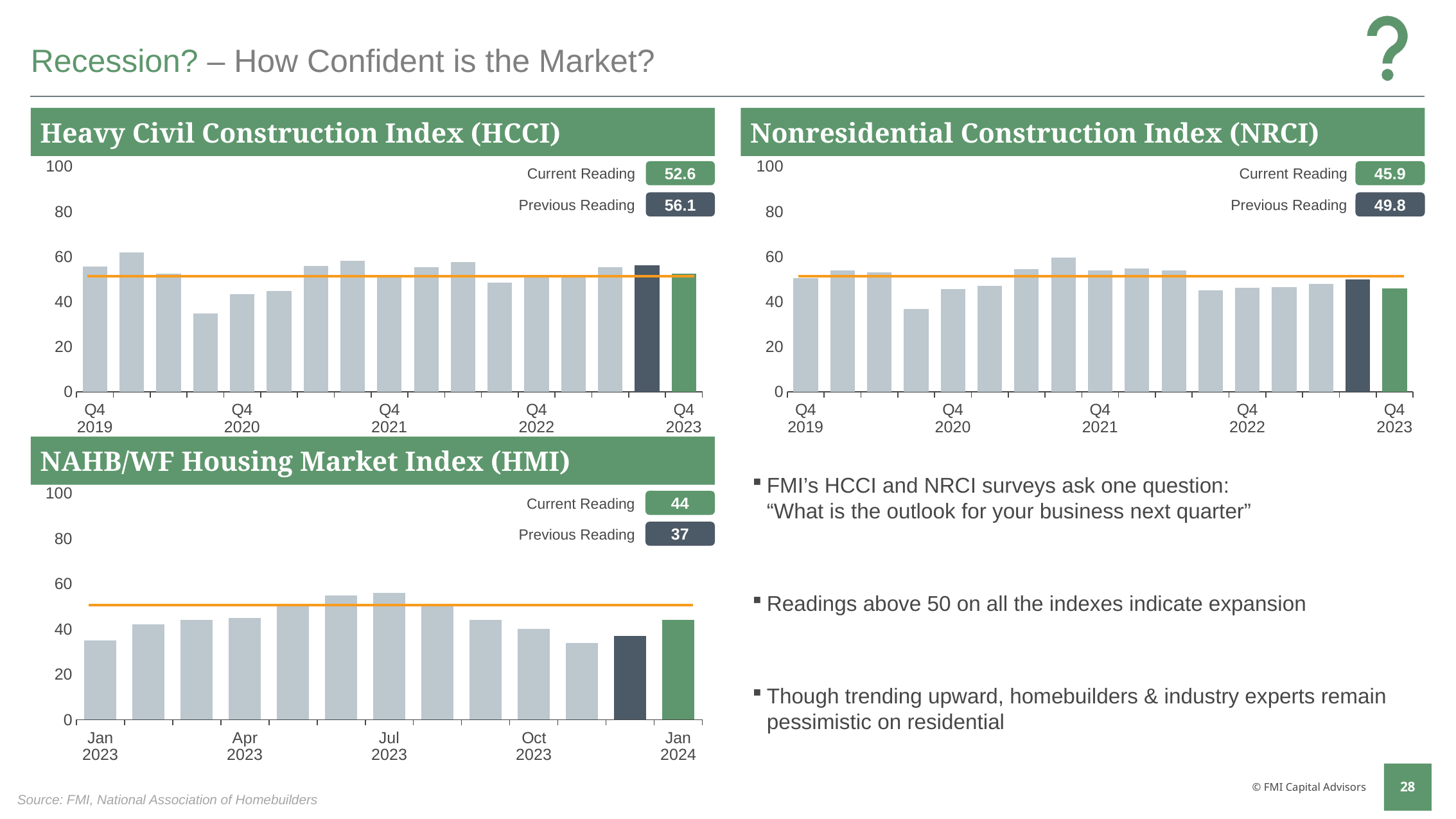
On the Nonresidential Construction Index (NRCI) chart, what is the Current Reading? 45.9 On the NAHB/WF Housing Market Index (HMI) chart, is the value for Jan 2023 greater or less than 40? less On the Heavy Civil Construction Index (HCCI) chart, what is the difference between the Previous Reading and the Current Reading? 3.5 On the Nonresidential Construction Index (NRCI) chart, which is larger, the Current Reading or the Previous Reading? Previous Reading On the NAHB/WF Housing Market Index (HMI) chart, what is the Current Reading? 44 On the Heavy Civil Construction Index (HCCI) chart, what is the Previous Reading? 56.1 On the NAHB/WF Housing Market Index (HMI) chart, which is larger, the Current Reading or the Previous Reading? Current Reading What kind of chart is the Heavy Civil Construction Index (HCCI) chart? Bar chart How many bars are plotted on the NAHB/WF Housing Market Index (HMI) chart? 13 On the Heavy Civil Construction Index (HCCI) chart, what is the Current Reading? 52.6 On the NAHB/WF Housing Market Index (HMI) chart, what is the Previous Reading? 37 On the Nonresidential Construction Index (NRCI) chart, what is the Previous Reading? 49.8